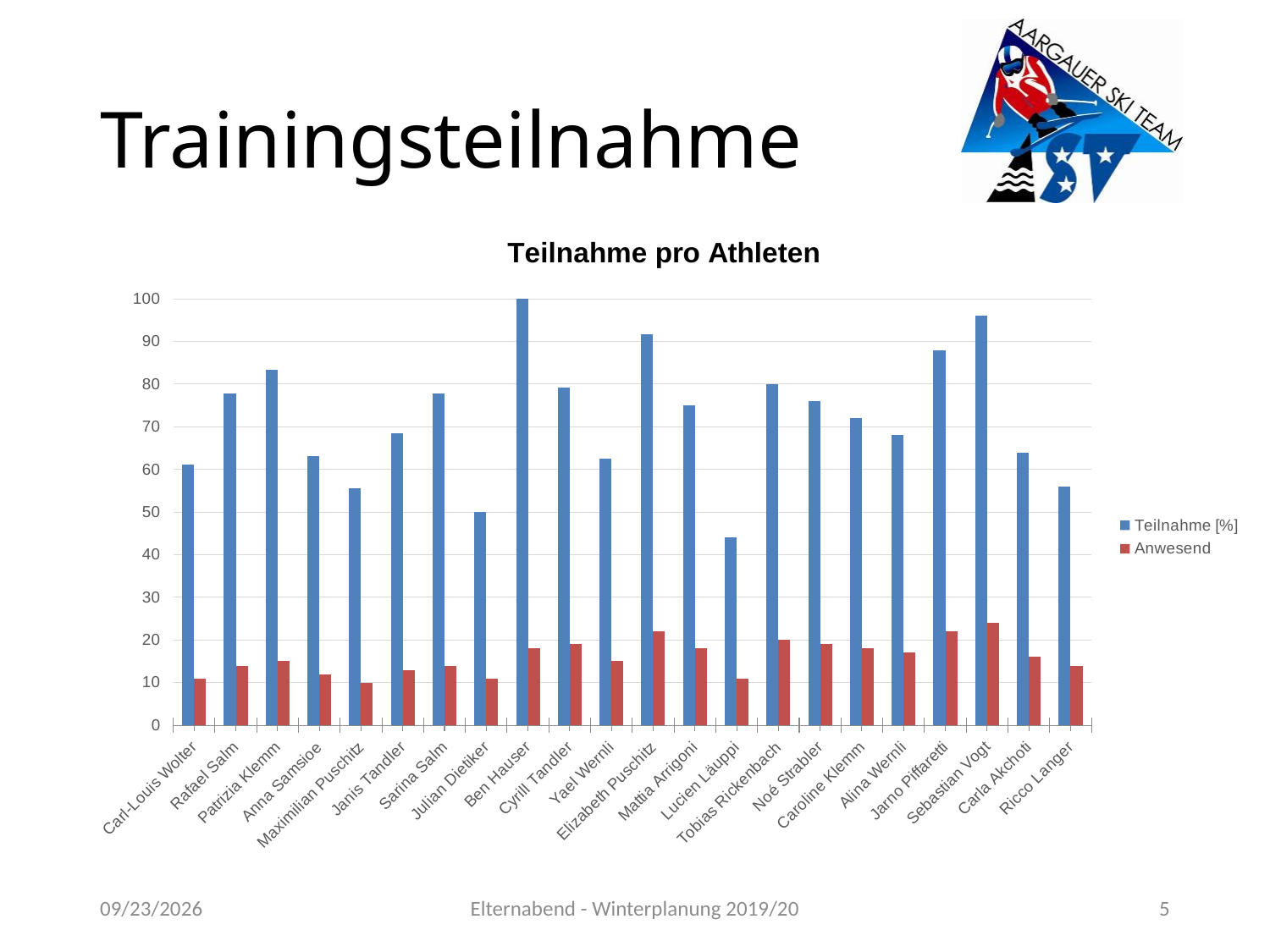
Is the Teilnahme [%] value for Patrizia Klemm greater or less than 80? greater Which athlete has the highest Teilnahme [%] value? Ben Hauser Which athlete has the lowest Teilnahme [%] value? Lucien Läuppi Is the Teilnahme [%] value for Sebastian Vogt greater or less than 90? greater What is the title of the chart? Teilnahme pro Athleten What is the Teilnahme [%] value for Ben Hauser? 100 Who has the larger Teilnahme [%] value, Cyrill Tandler or Yael Wernli? Cyrill Tandler How many series does the chart legend list? 2 What type of chart is shown on the slide? Bar chart What is the Teilnahme [%] value for Julian Dietiker? 50 How many athletes are shown on the x axis of the chart? 22 Is the Teilnahme [%] value for Maximilian Puschitz greater or less than 60? less